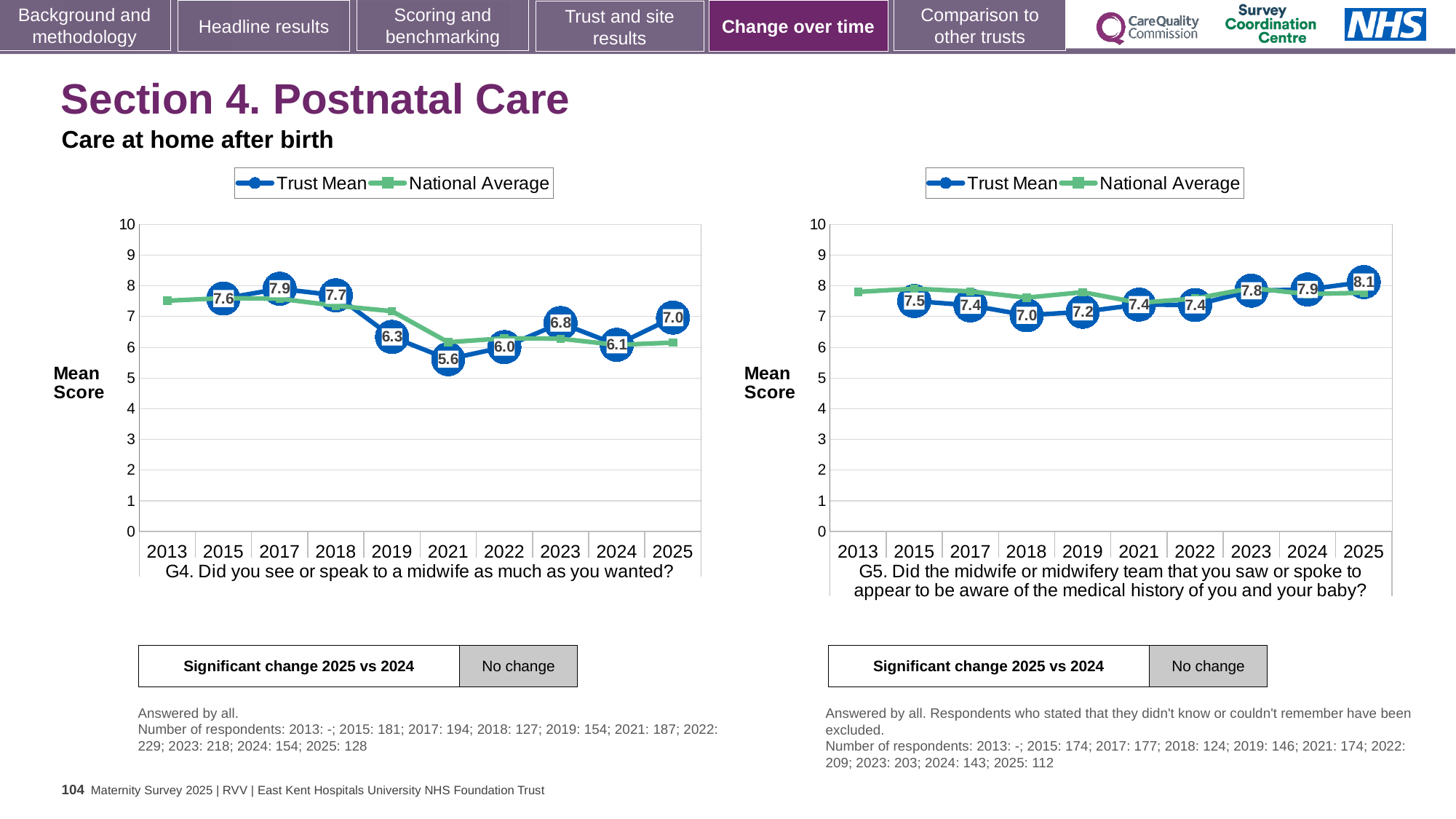
In the G5 chart (right), which year has the highest Trust Mean score? 2025 In the G5 chart (right), does the Trust Mean rise or fall from 2022 to 2025? Rise In the G5 chart (right), is the Trust Mean score higher in 2024 or 2018? 2024 In the G4 chart (left), what is the Trust Mean score for 2021? 5.6 In the G5 chart (right), what is the Trust Mean score for 2018? 7.0 In the G5 chart (right), how many series does the legend list? 2 In the G5 chart (right), is the National Average value for 2013 greater or less than 7? greater In the G4 chart (left), which year has the lowest Trust Mean score? 2021 In the G4 chart (left), what is the difference between the Trust Mean scores for 2017 and 2021? 2.3 In the G4 chart (left), what is the Trust Mean score for 2025? 7.0 What type of chart is the G4 chart on the left? Line chart In the G4 chart (left), which year has the highest Trust Mean score? 2017